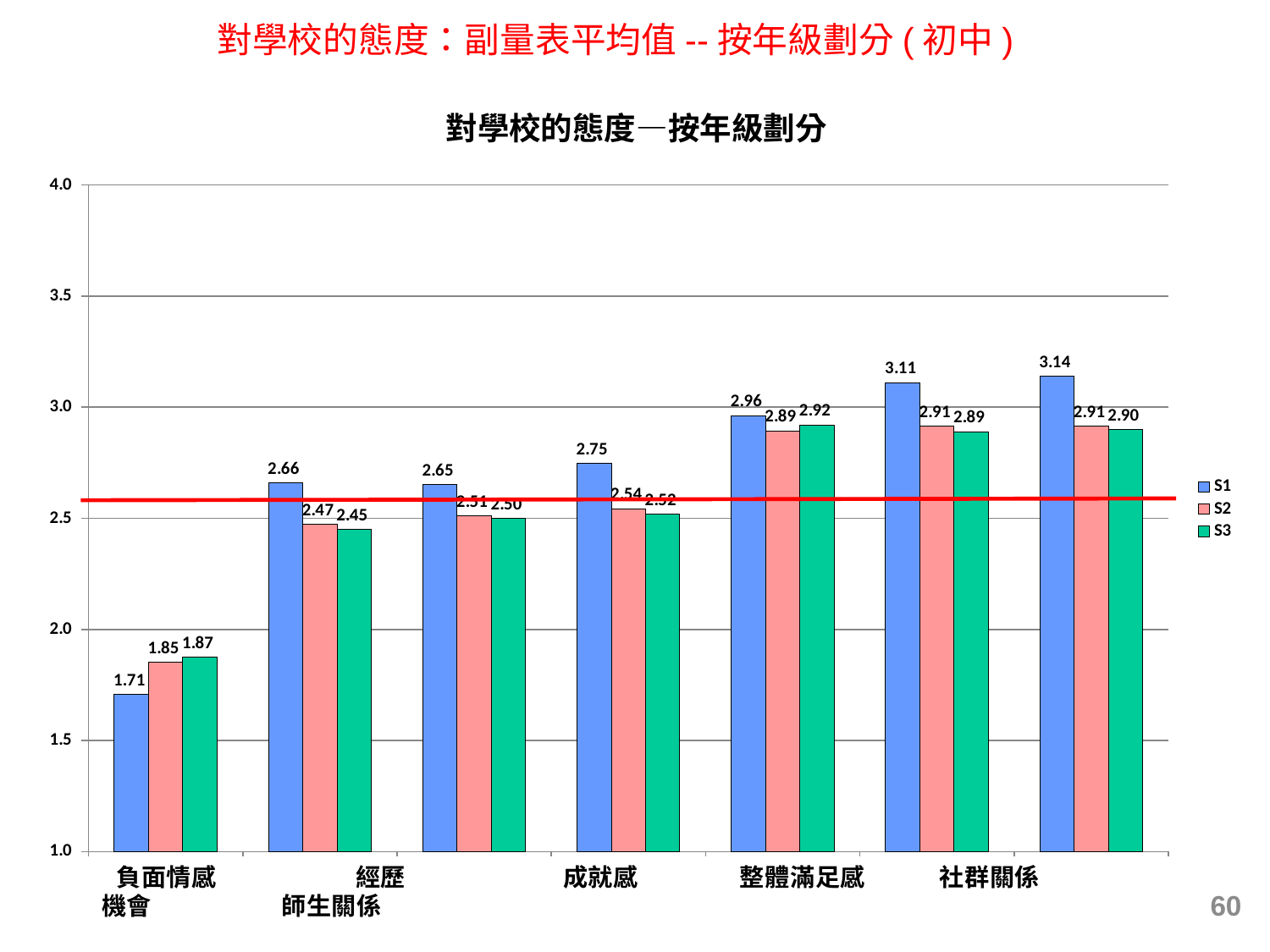
How many groups of bars are plotted in the chart? 7 What kind of chart is shown on the slide? bar chart What is the S1 value for 負面情感? 1.71 Which category has the lowest S1 value? 負面情感 How many series does the legend list? 3 What are the entries listed in the legend? S1, S2, S3